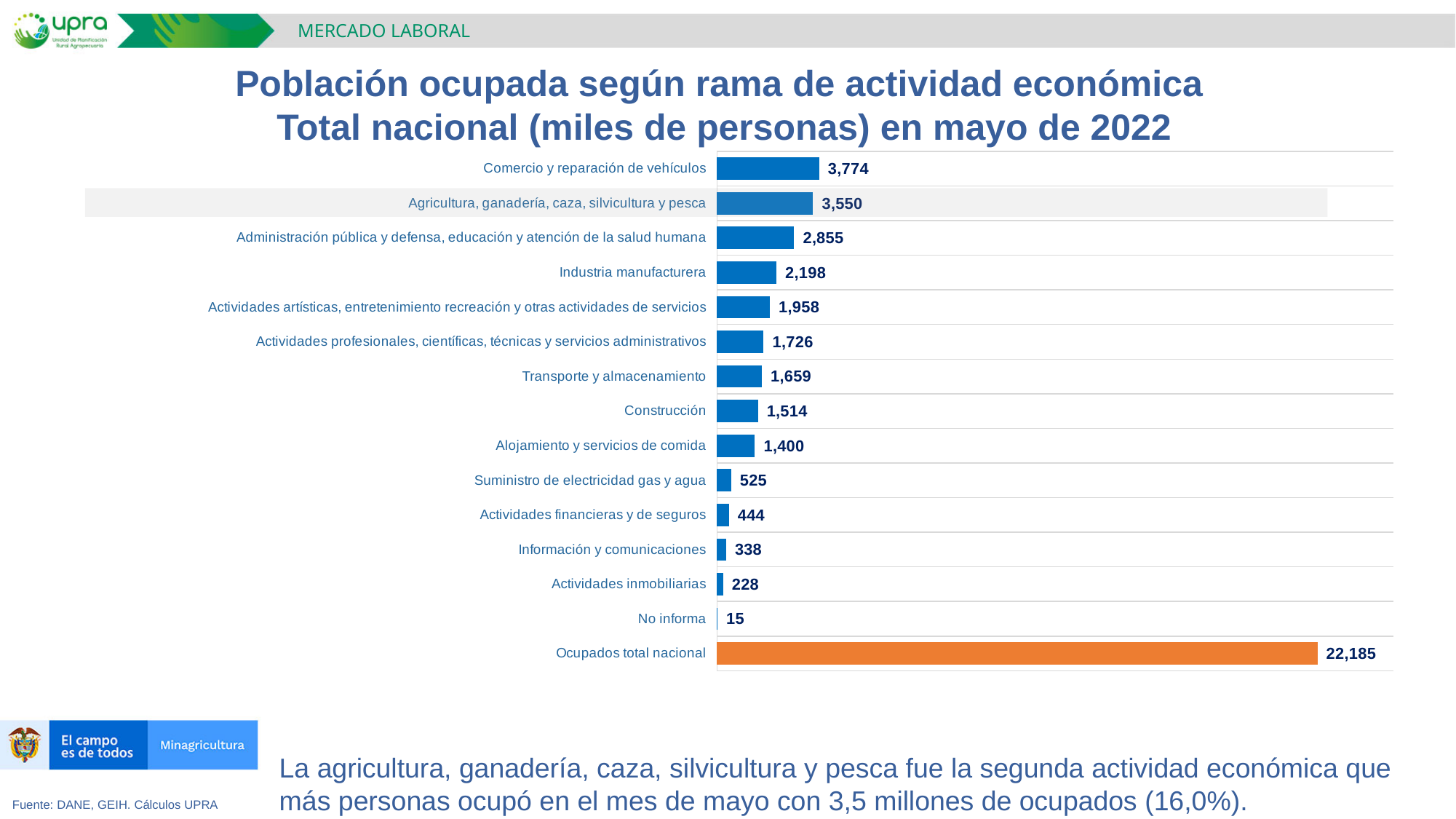
Which category has the lowest value? No informa What kind of chart is shown on the slide? Bar chart Excluding the Ocupados total nacional bar, which economic activity has the highest value? Comercio y reparación de vehículos What is the value for No informa? 15 What is the value for Industria manufacturera? 2,198 What is the difference between Administración pública y defensa, educación y atención de la salud humana and Industria manufacturera? 657 Which is larger, Transporte y almacenamiento or Construcción? Transporte y almacenamiento What is the value for Agricultura, ganadería, caza, silvicultura y pesca? 3,550 What is the difference between Comercio y reparación de vehículos and Agricultura, ganadería, caza, silvicultura y pesca? 224 How many bars are plotted in the chart? 15 What is the value for Comercio y reparación de vehículos? 3,774 What is the value for Ocupados total nacional? 22,185